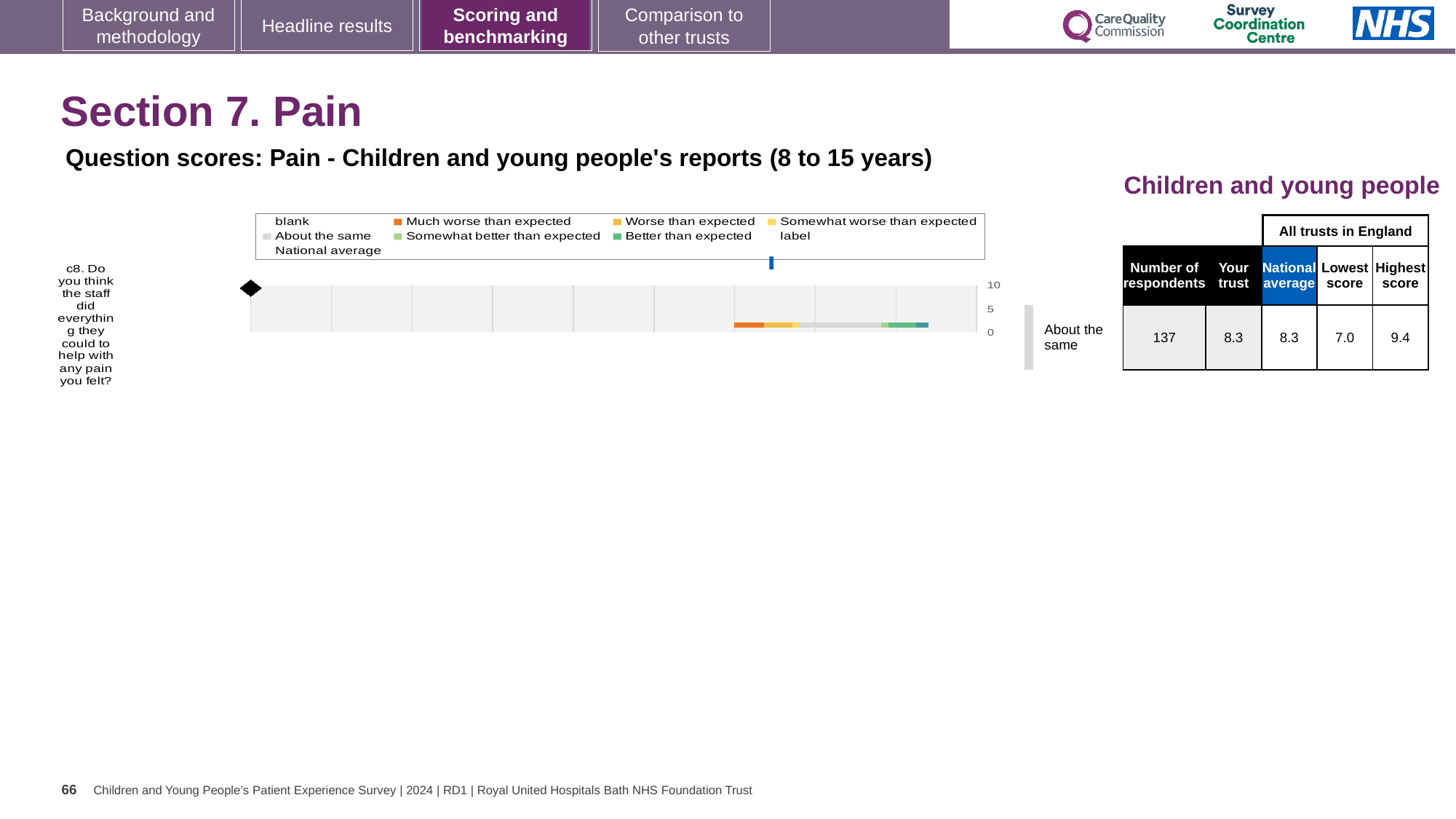
How many entries does the chart legend list? 9 How many respondents answered question c8? 137 What kind of chart is shown on the slide? Bar chart What is the highest value shown on the chart's axis? 10 What is the lowest score among all trusts in England for question c8? 7.0 How many questions (categories) are plotted in the chart? 1 What colour represents 'Much worse than expected' in the chart legend? Orange What is the highest score among all trusts in England for question c8? 9.4 What is the national average score for question c8? 8.3 What is the difference between the highest and lowest scores for question c8? 2.4 Which survey question is plotted in the chart? c8. Do you think the staff did everything they could to help with any pain you felt? What is the 'Your trust' score for question c8 in the table next to the chart? 8.3